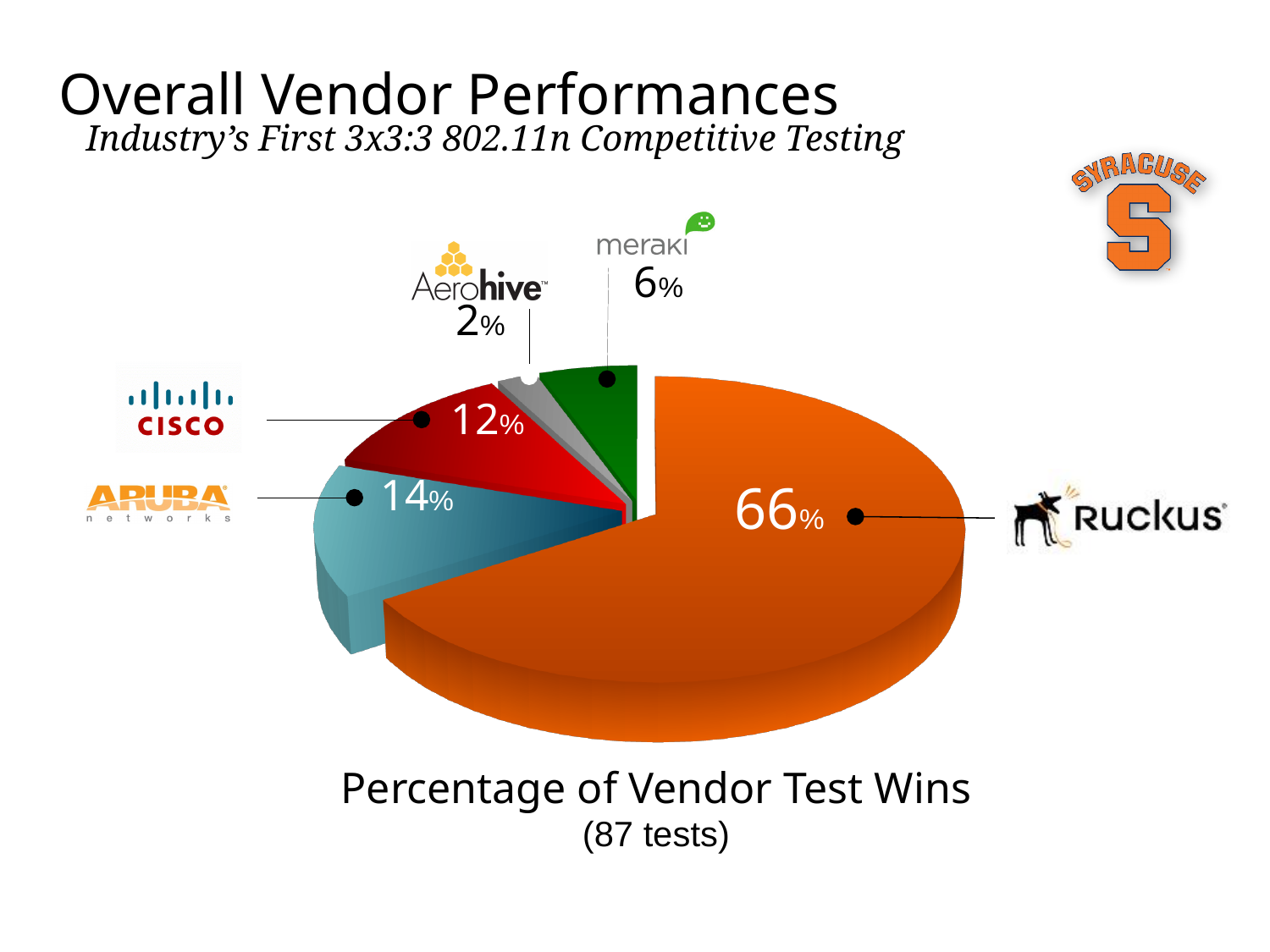
What percentage of vendor test wins does Meraki have? 6% What kind of chart is shown on the slide? Pie chart Which vendor has the smallest share of test wins? Aerohive What is the difference in percentage points between Ruckus and Aruba? 52 What percentage of vendor test wins does Ruckus have? 66% How many tests does the chart caption say the percentages are based on? 87 tests What percentage of vendor test wins does Cisco have? 12% How many vendors are shown in the pie chart? 5 Which vendor has the largest share of test wins? Ruckus What percentage of vendor test wins does Aerohive have? 2% What percentage of vendor test wins does Aruba have? 14% Which vendor has a larger share of test wins, Cisco or Meraki? Cisco